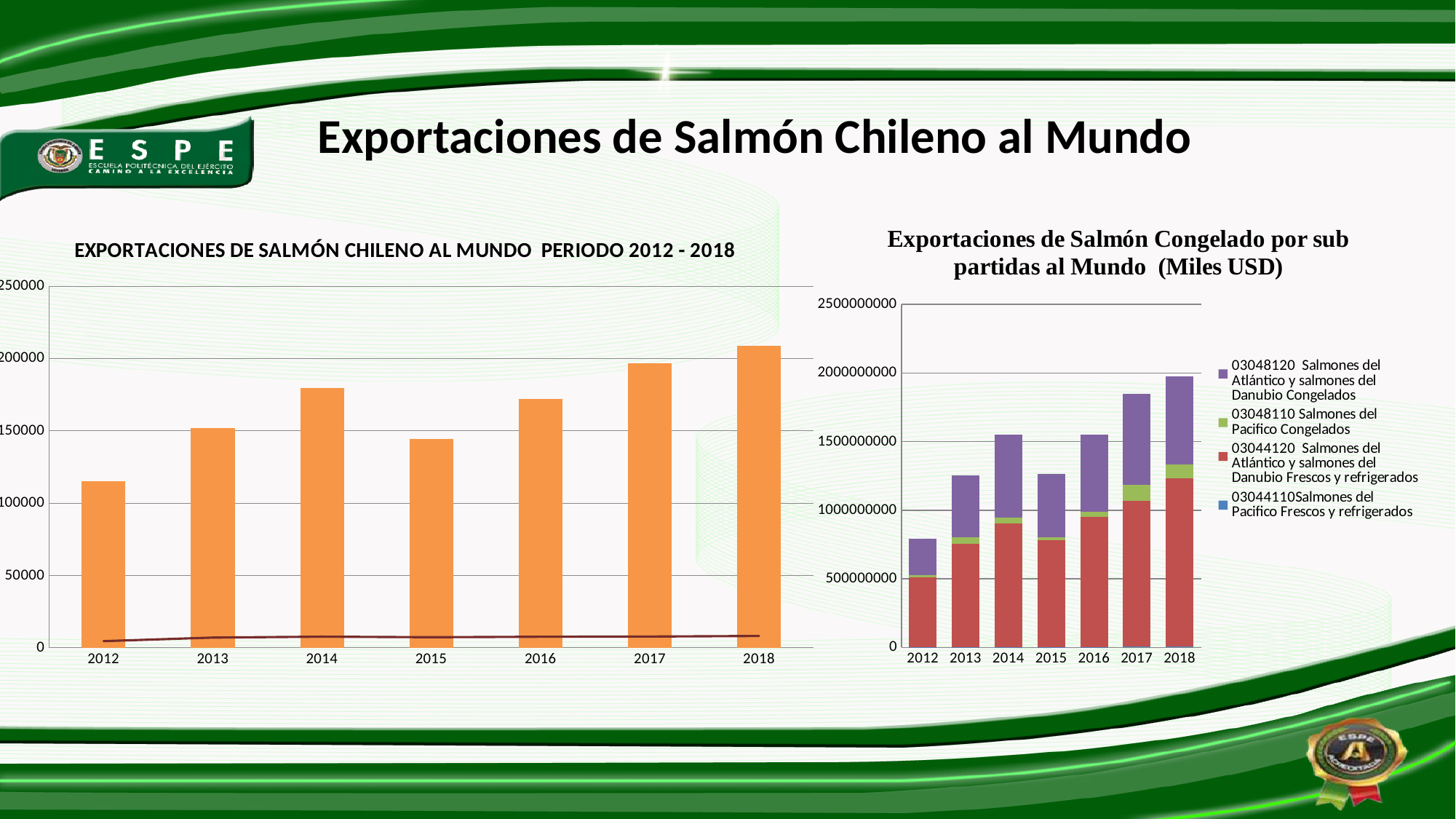
In the right chart, is the total stacked bar for 2017 greater or less than 1500000000? greater In the right chart, which year has the tallest stacked bar? 2018 In the right chart titled 'Exportaciones de Salmón Congelado por sub partidas al Mundo (Miles USD)', how many series does the legend list? 4 In the left chart, which year has the larger bar, 2014 or 2015? 2014 In the left chart, is the value for 2018 greater or less than 200000? greater In the left chart, which year has the lowest bar? 2012 In the left chart, is the value for 2012 greater or less than 150000? less In the left chart titled 'EXPORTACIONES DE SALMÓN CHILENO AL MUNDO PERIODO 2012 - 2018', what kind of chart is used for the yearly values? Bar chart In the left chart, how many years are shown on the x axis? 7 In the right chart, which year has the shortest stacked bar? 2012 In the right chart, which colour represents the series '03048120 Salmones del Atlántico y salmones del Danubio Congelados'? Purple In the left chart, which year has the highest bar? 2018